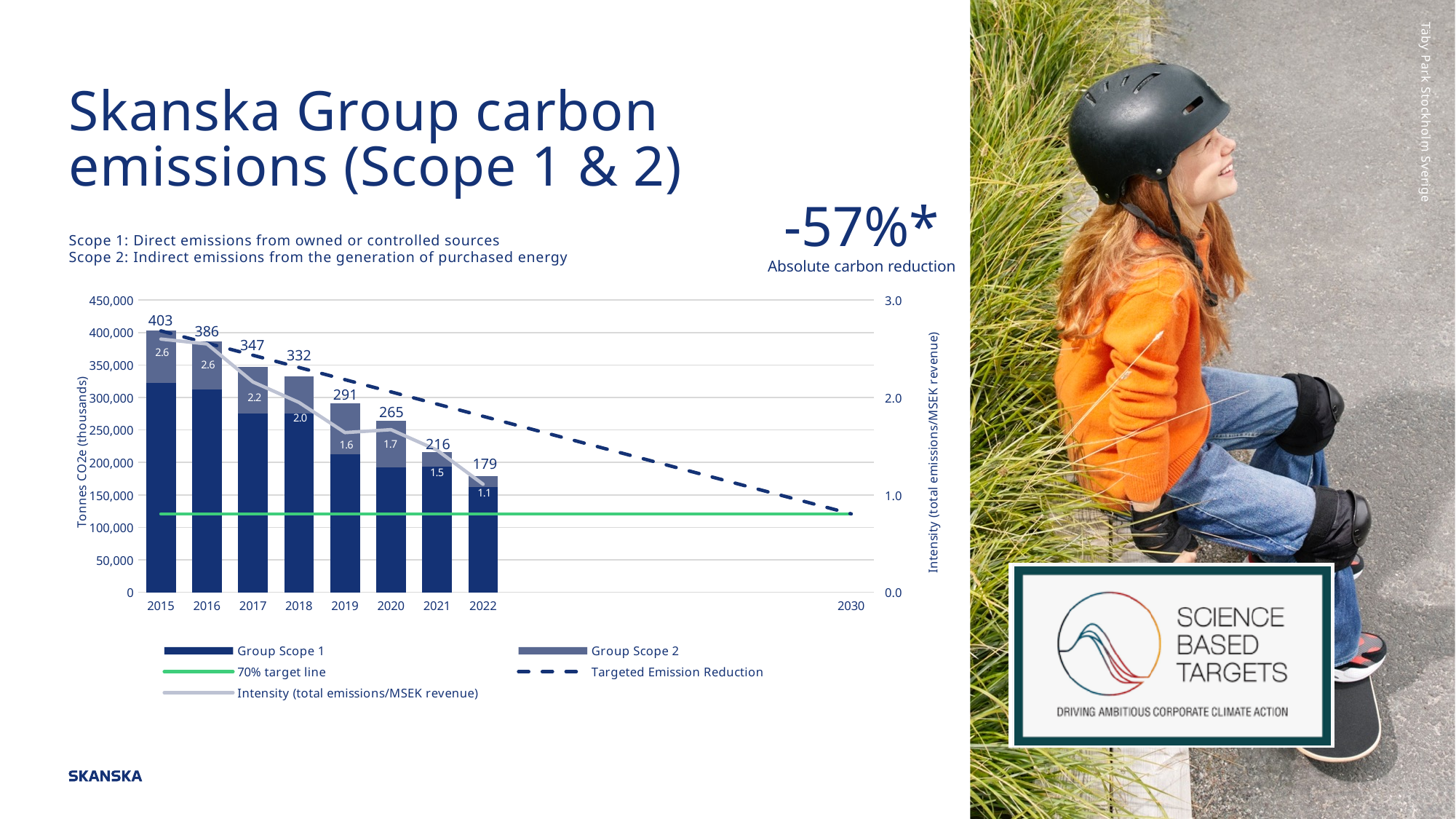
How many years have emissions bars plotted in the chart? 8 What is the absolute carbon reduction percentage stated on the slide? -57%* What is the total carbon emissions label shown above the bar for 2022? 179 Is the Group Scope 1 value for 2015 greater or less than 300,000 tonnes CO2e? greater What is the difference between the total emissions labels for 2015 and 2022? 224 Which year has the larger total emissions label, 2018 or 2020? 2018 Do the total emissions bars rise or fall from 2015 to 2022? fall How many series does the legend list? 5 What is the total carbon emissions label shown above the bar for 2015? 403 What is the intensity (total emissions/MSEK revenue) value labelled for 2019? 1.6 Which year has the highest total emissions bar? 2015 Which year has the lowest total emissions bar? 2022